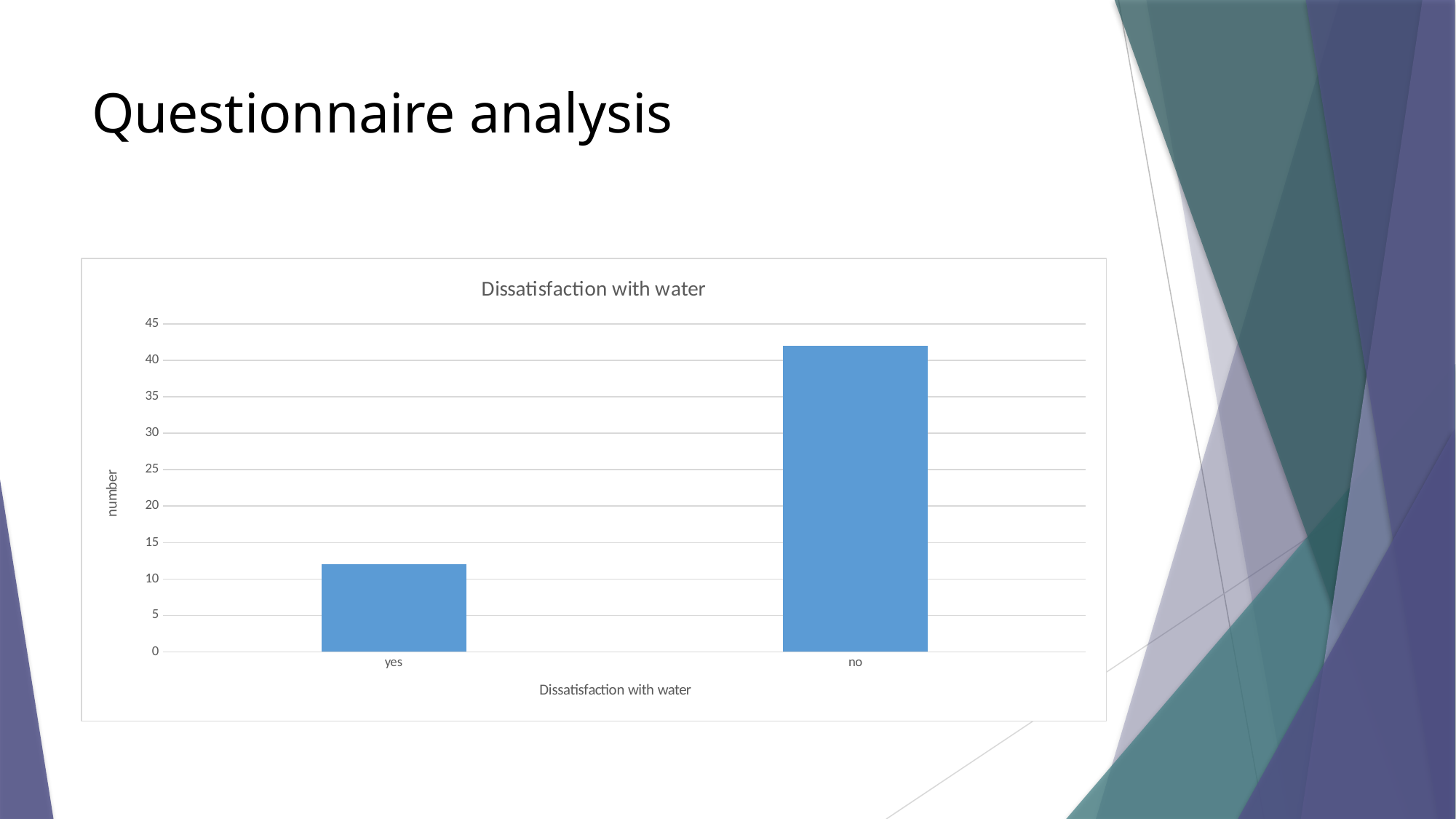
Which category has the highest value in the chart? no Is the value for "yes" greater or less than 15? less What is the label on the vertical axis of the chart? number Which is larger, the value for "yes" or the value for "no"? no Which category has the lowest value in the chart? yes Is the value for "yes" greater or less than 10? greater Is the value for "no" greater or less than 40? greater How many categories are plotted on the x axis of the chart? 2 What kind of chart is shown on the slide? bar chart What is the title of the chart? Dissatisfaction with water